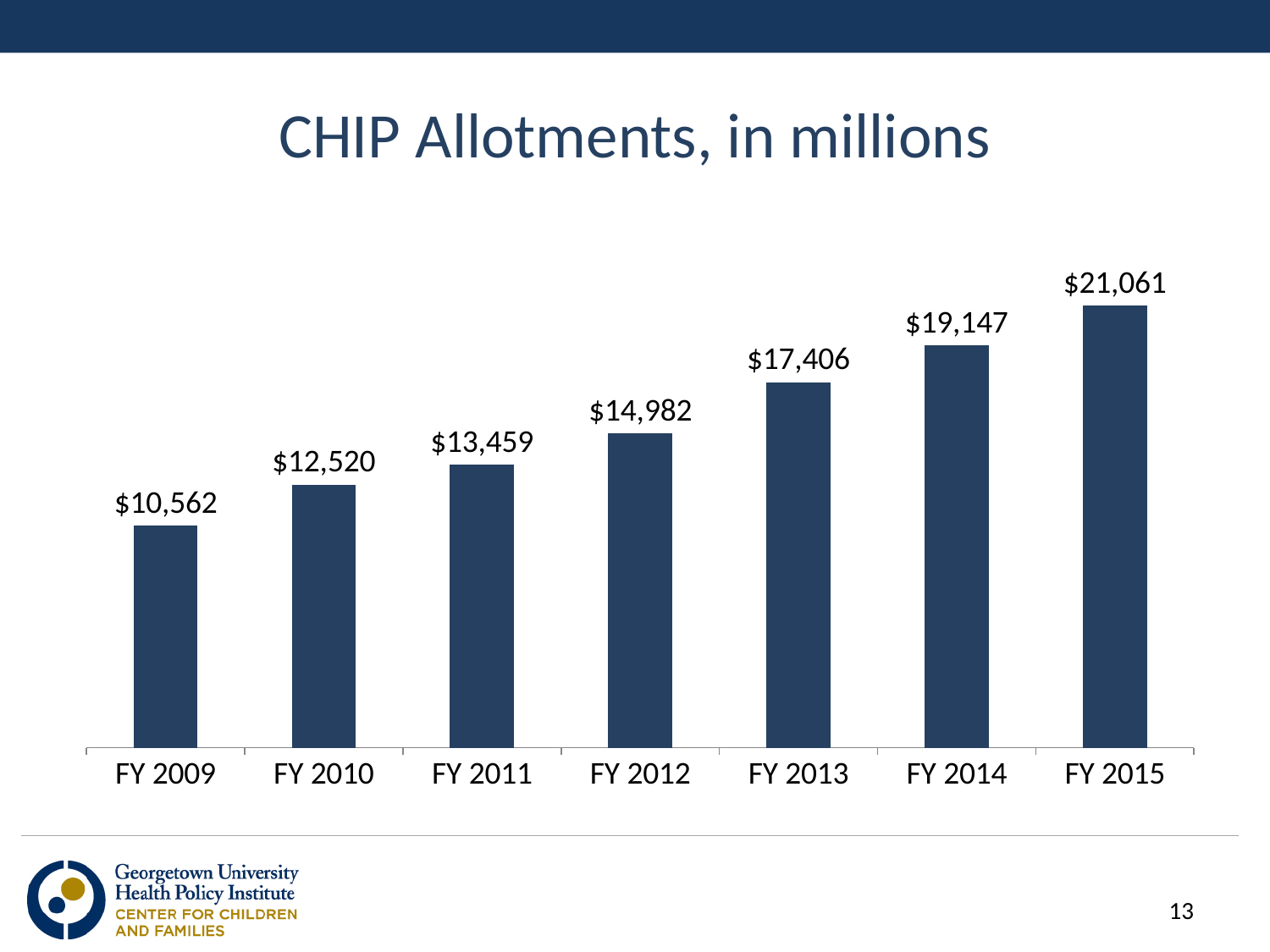
What kind of chart is shown on the slide? Bar chart What is the CHIP allotment for FY 2012? $14,982 Which fiscal year has the lowest CHIP allotment? FY 2009 How many fiscal years are shown in the chart? 7 What is the difference between the CHIP allotments for FY 2011 and FY 2010? $939 What is the title of the chart? CHIP Allotments, in millions What is the CHIP allotment for FY 2014? $19,147 What is the CHIP allotment for FY 2009? $10,562 Do the CHIP allotments rise or fall from FY 2009 to FY 2015? Rise What is the difference between the CHIP allotments for FY 2015 and FY 2014? $1,914 Which fiscal year has the highest CHIP allotment? FY 2015 Which is larger, the CHIP allotment for FY 2013 or for FY 2012? FY 2013